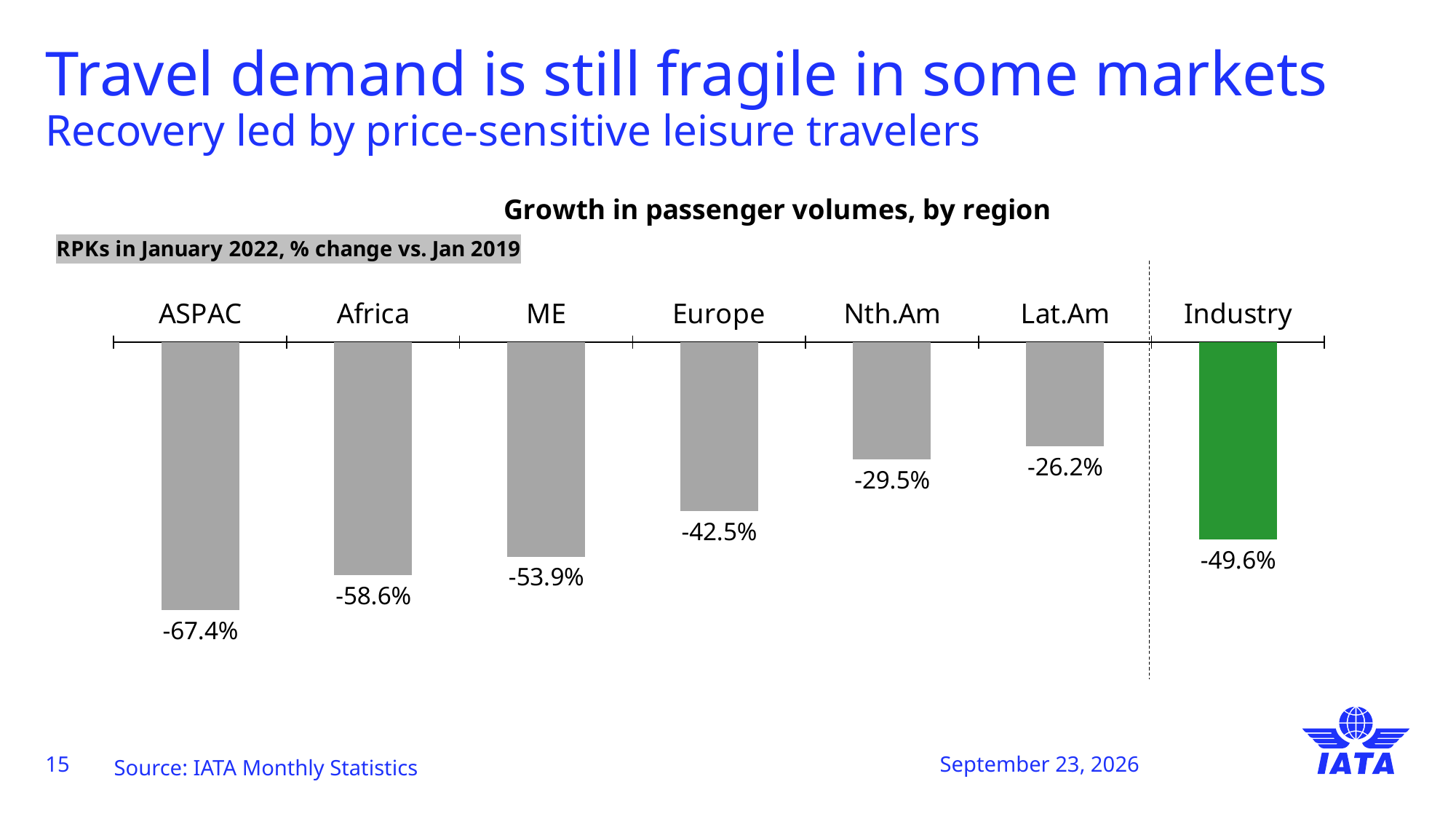
What kind of chart is shown on the slide? Bar chart What is the title of the chart? Growth in passenger volumes, by region What is the value for Lat.Am? -26.2% Which is larger, the value for Europe or the value for Industry? Europe What is the difference between the values for Africa and ME? 4.7 percentage points What is the value for Europe? -42.5% Which region has the lowest value (largest decline)? ASPAC What is the value for ASPAC? -67.4% What is the value for Industry? -49.6% What is the difference between the values for Nth.Am and Lat.Am? 3.3 percentage points How many categories are shown in the chart? 7 Which category has the highest value (smallest decline)? Lat.Am